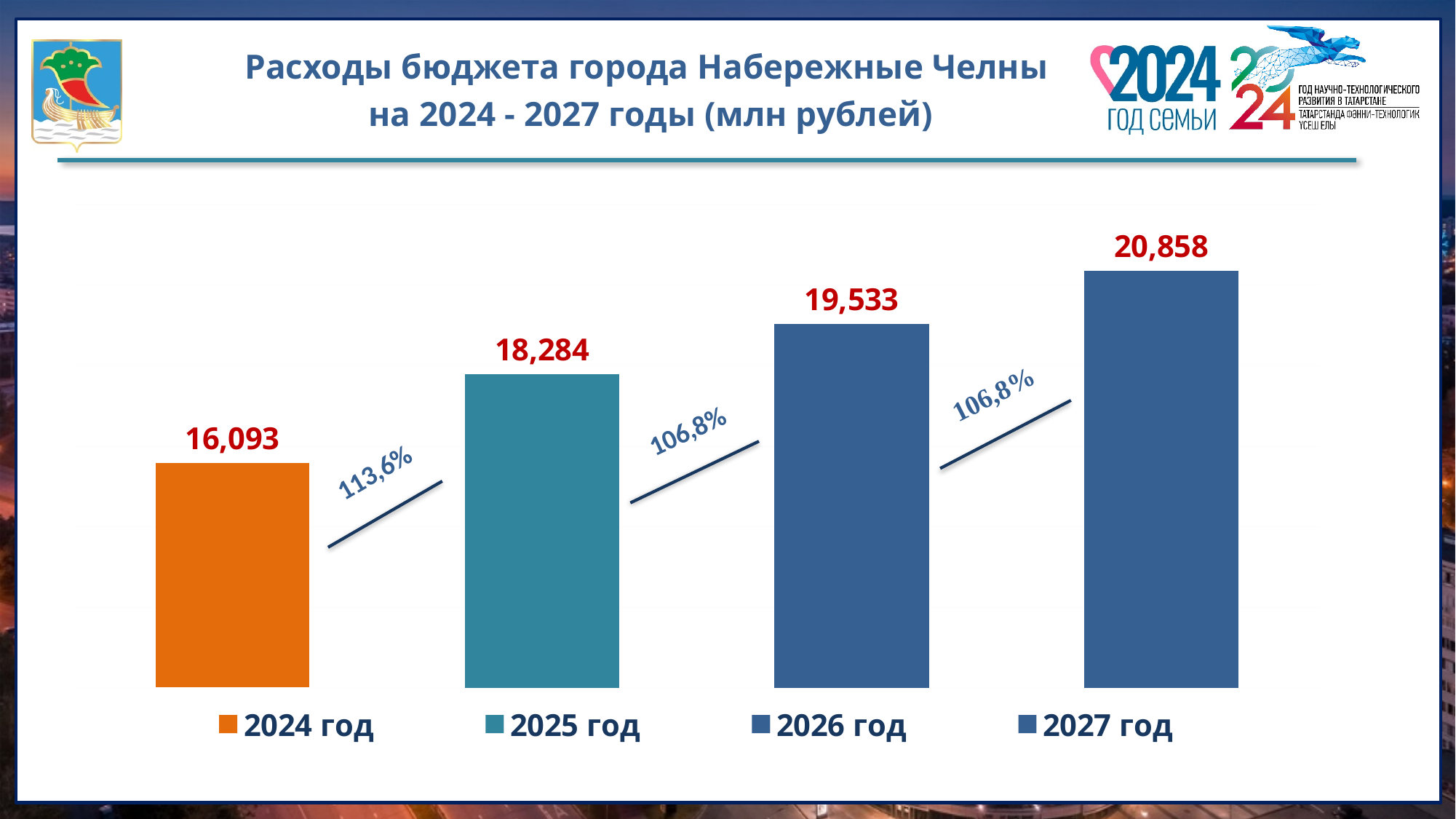
What is the difference between the values for 2027 год and 2026 год? 1,325 How many years (bars) are shown in the chart? 4 Which year has the highest budget expenditure? 2027 год What is the value shown for 2027 год? 20,858 What is the difference between the values for 2025 год and 2024 год? 2,191 What is the value shown for 2026 год? 19,533 What is the budget expenditure value shown for 2024 год? 16,093 What is the value shown for 2025 год? 18,284 What growth percentage is shown between 2024 год and 2025 год? 113,6% Which is larger, the value for 2026 год or the value for 2025 год? 2026 год What type of chart is shown on the slide? Bar chart Which year has the lowest budget expenditure? 2024 год